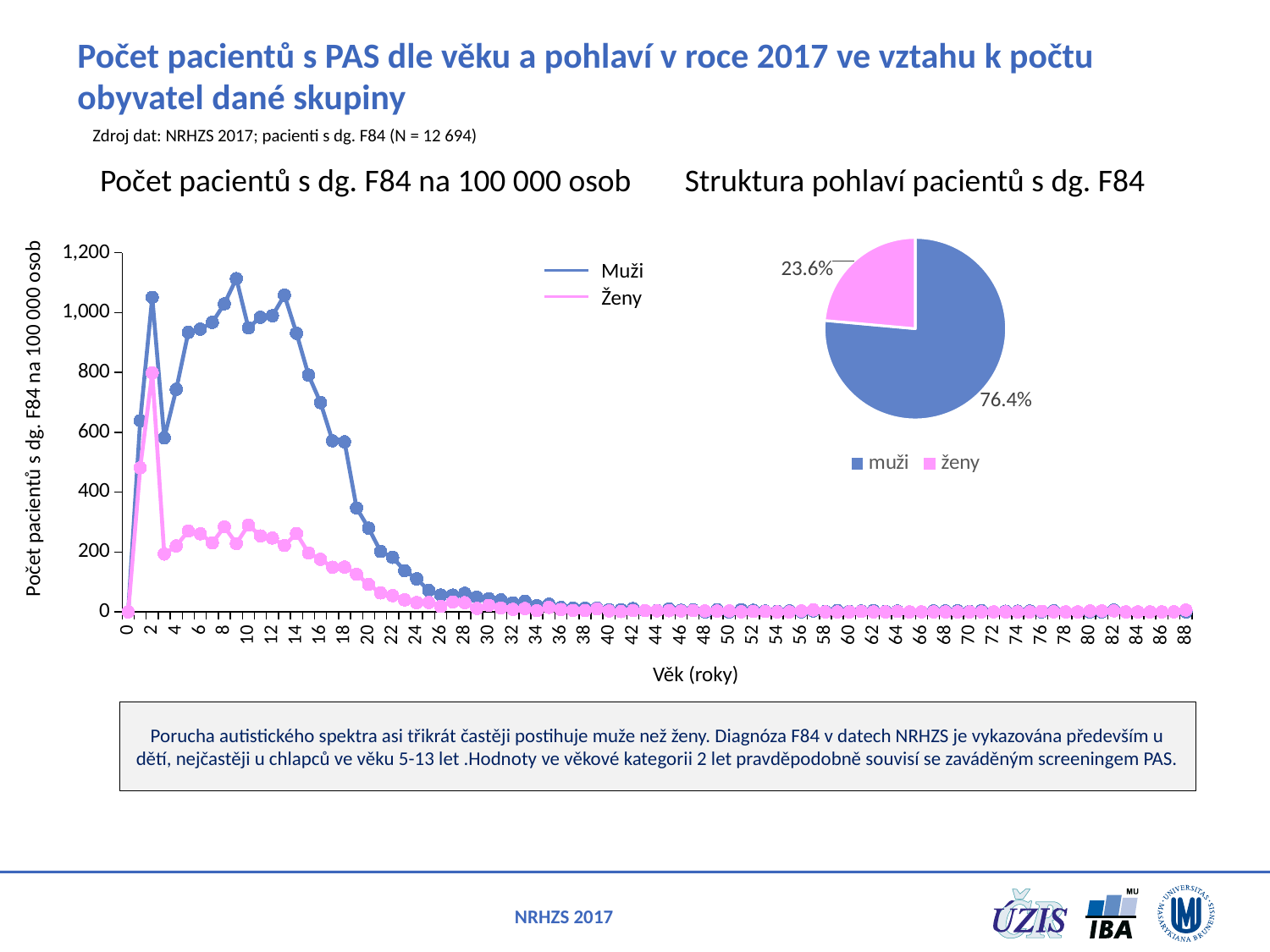
What kind of chart is 'Struktura pohlaví pacientů s dg. F84'? pie chart In the pie chart 'Struktura pohlaví pacientů s dg. F84', by how many percentage points does the muži share exceed the ženy share? 52.8 percentage points In the chart 'Počet pacientů s dg. F84 na 100 000 osob', which series is higher at age 9, Muži or Ženy? Muži In the chart 'Počet pacientů s dg. F84 na 100 000 osob', is the value for Muži at age 30 greater or less than 200? less In the pie chart 'Struktura pohlaví pacientů s dg. F84', which slice is larger, muži or ženy? muži How many series does the legend of the chart 'Počet pacientů s dg. F84 na 100 000 osob' list? 2 In the pie chart 'Struktura pohlaví pacientů s dg. F84', what share of patients are ženy? 23.6% In the chart 'Počet pacientů s dg. F84 na 100 000 osob', do the Muži values rise or fall between age 13 and age 30? fall What kind of chart is 'Počet pacientů s dg. F84 na 100 000 osob'? line chart In the chart 'Počet pacientů s dg. F84 na 100 000 osob', is the value for Muži at age 9 greater or less than 1,000? greater In the pie chart 'Struktura pohlaví pacientů s dg. F84', what share of patients are muži? 76.4% How many slices does the pie chart 'Struktura pohlaví pacientů s dg. F84' have? 2